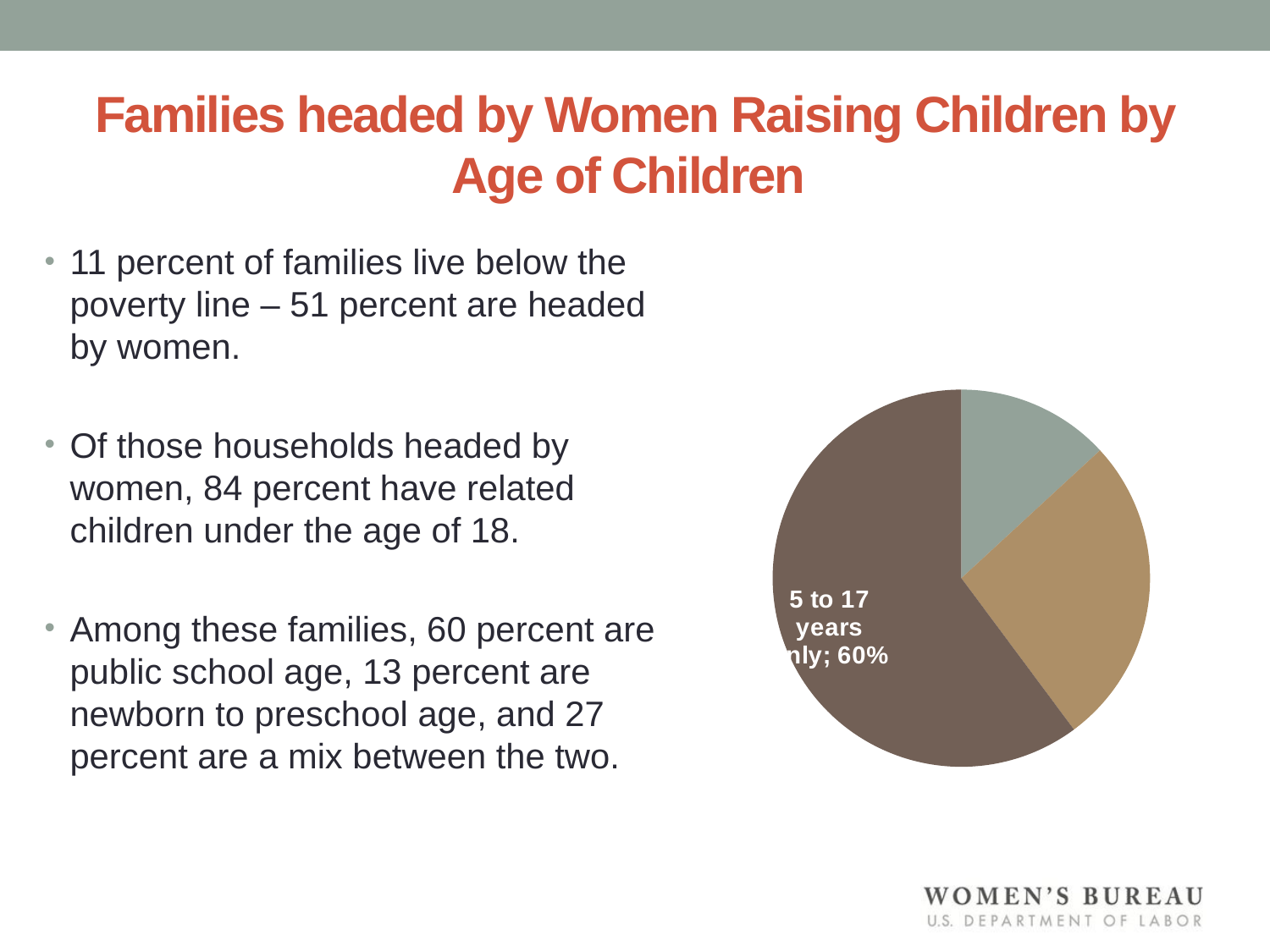
Does the "5 to 17 years only" slice make up more or less than half of the pie? more How many slices does the pie chart have? 3 How many slices of the pie chart have a readable data label? 1 Which slice of the pie chart is the smallest? the grey-green slice Which slice of the pie chart is the largest? 5 to 17 years only What colour is the slice labelled "5 to 17 years only; 60%"? dark brown What kind of chart is shown on the slide? pie chart Is the tan slice or the grey-green slice of the pie larger? the tan slice What share of the pie is labelled "5 to 17 years only"? 60%